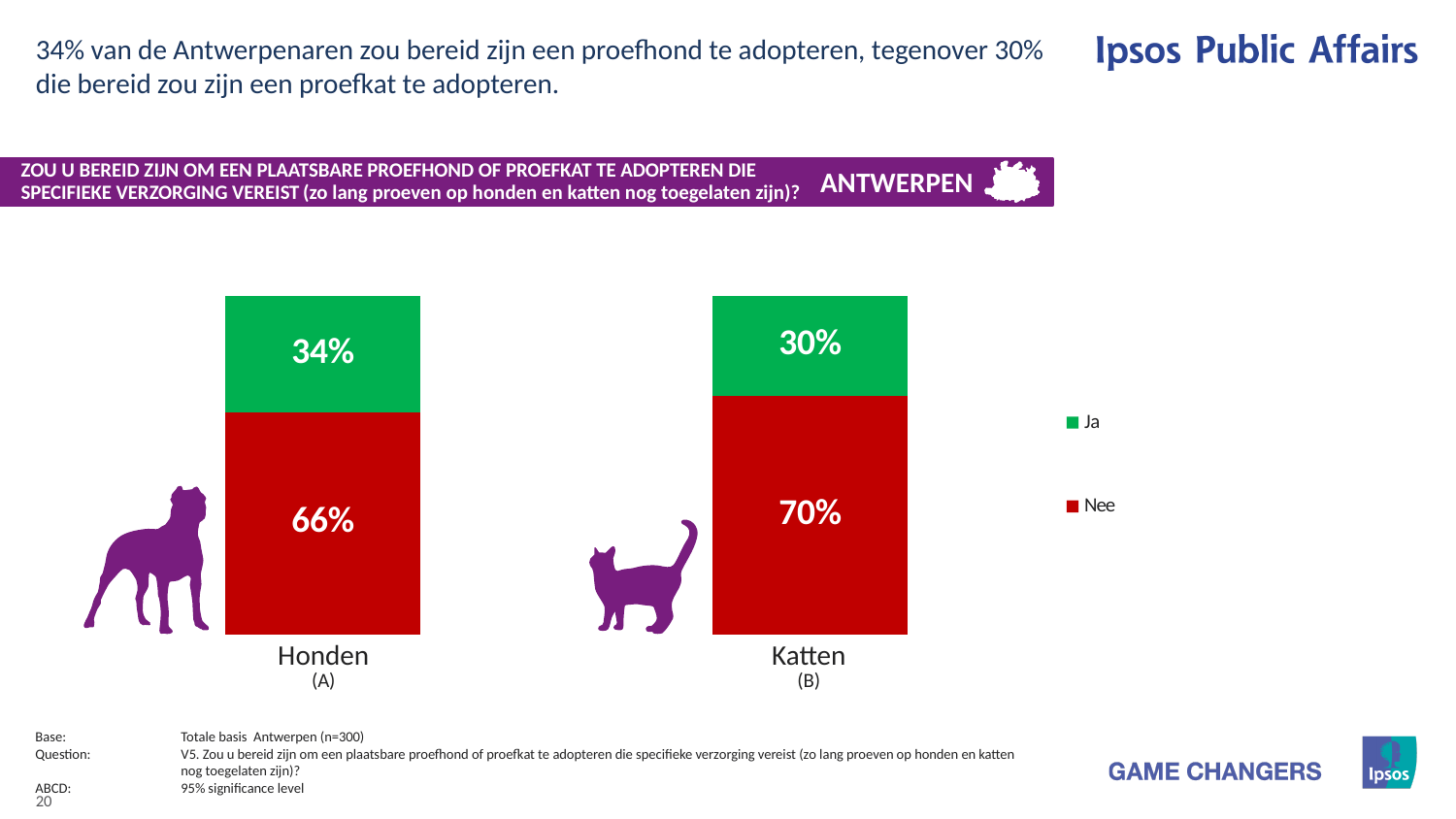
What is the difference between the 'Nee' values for Katten and Honden? 4% What is the 'Ja' value for Katten? 30% What is the 'Ja' value for Honden? 34% Which category has the highest 'Nee' value? Katten How many series does the legend list? 2 What is the total of the stacked bar for Honden? 100% What is the difference between the 'Ja' values for Honden and Katten? 4% Which category has the higher 'Ja' share, Honden or Katten? Honden What kind of chart is shown on the slide? Stacked bar chart How many categories are shown on the x axis? 2 What is the 'Nee' value for Katten? 70% What is the 'Nee' value for Honden? 66%